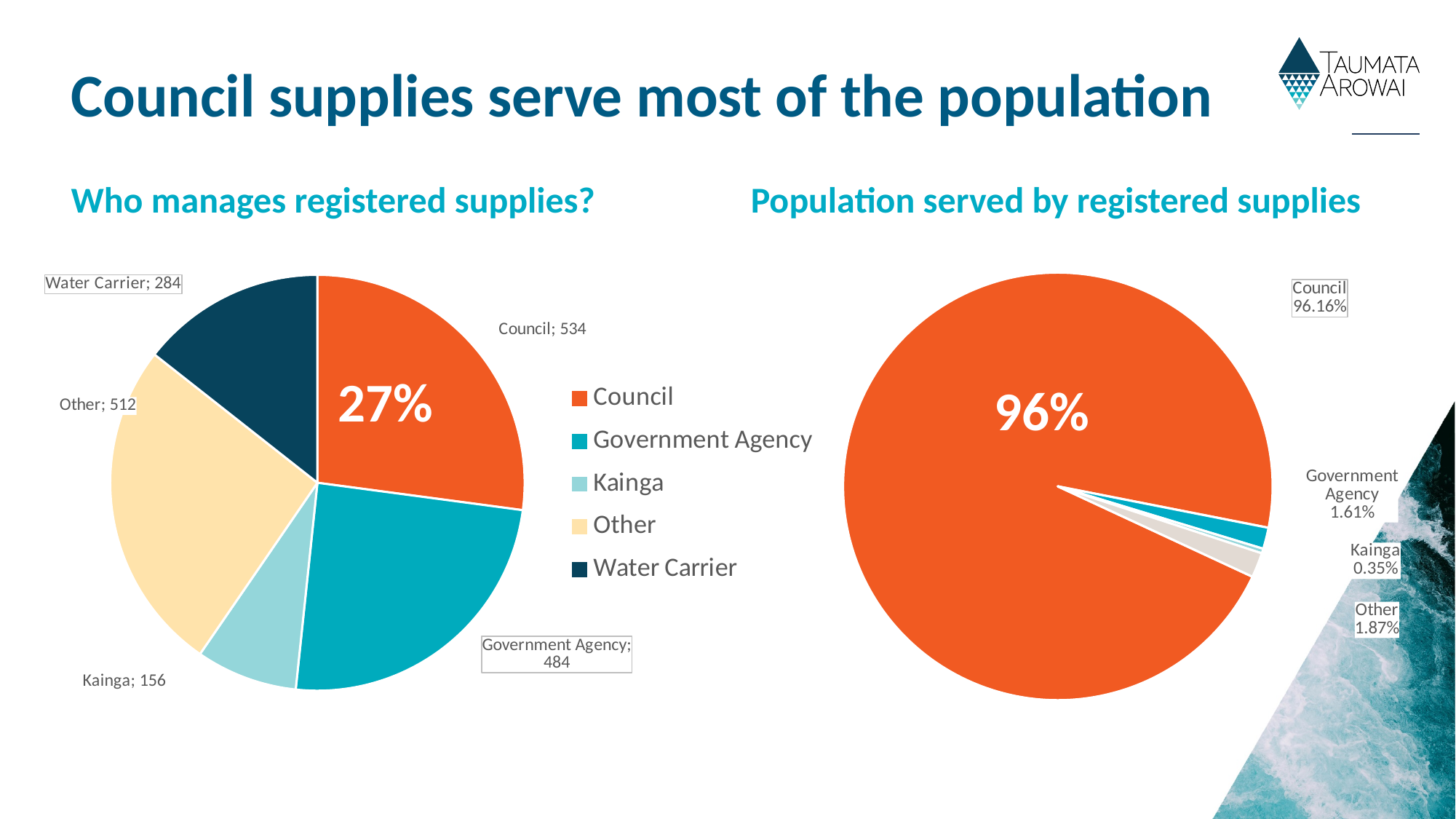
In the 'Who manages registered supplies?' chart, which category has the largest value? Council In the 'Population served by registered supplies' chart, what is the value for Kainga? 0.35% In the 'Who manages registered supplies?' chart, how many registered supplies are managed by Council? 534 In the 'Who manages registered supplies?' chart, which is larger: Other or Government Agency? Other In the 'Who manages registered supplies?' chart, what is the value for Kainga? 156 In the 'Who manages registered supplies?' chart, what is the difference between the Council value and the Water Carrier value? 250 In the 'Population served by registered supplies' chart, what percentage of the population is served by Council supplies? 96.16% In the 'Who manages registered supplies?' chart, what share of the pie does Council represent, as printed on the slice? 27% How many categories does the 'Who manages registered supplies?' pie chart show? 5 In the 'Who manages registered supplies?' chart, which category has the smallest value? Kainga What type of chart is used for 'Population served by registered supplies'? Pie chart In the 'Population served by registered supplies' chart, which is larger: Other or Government Agency? Other